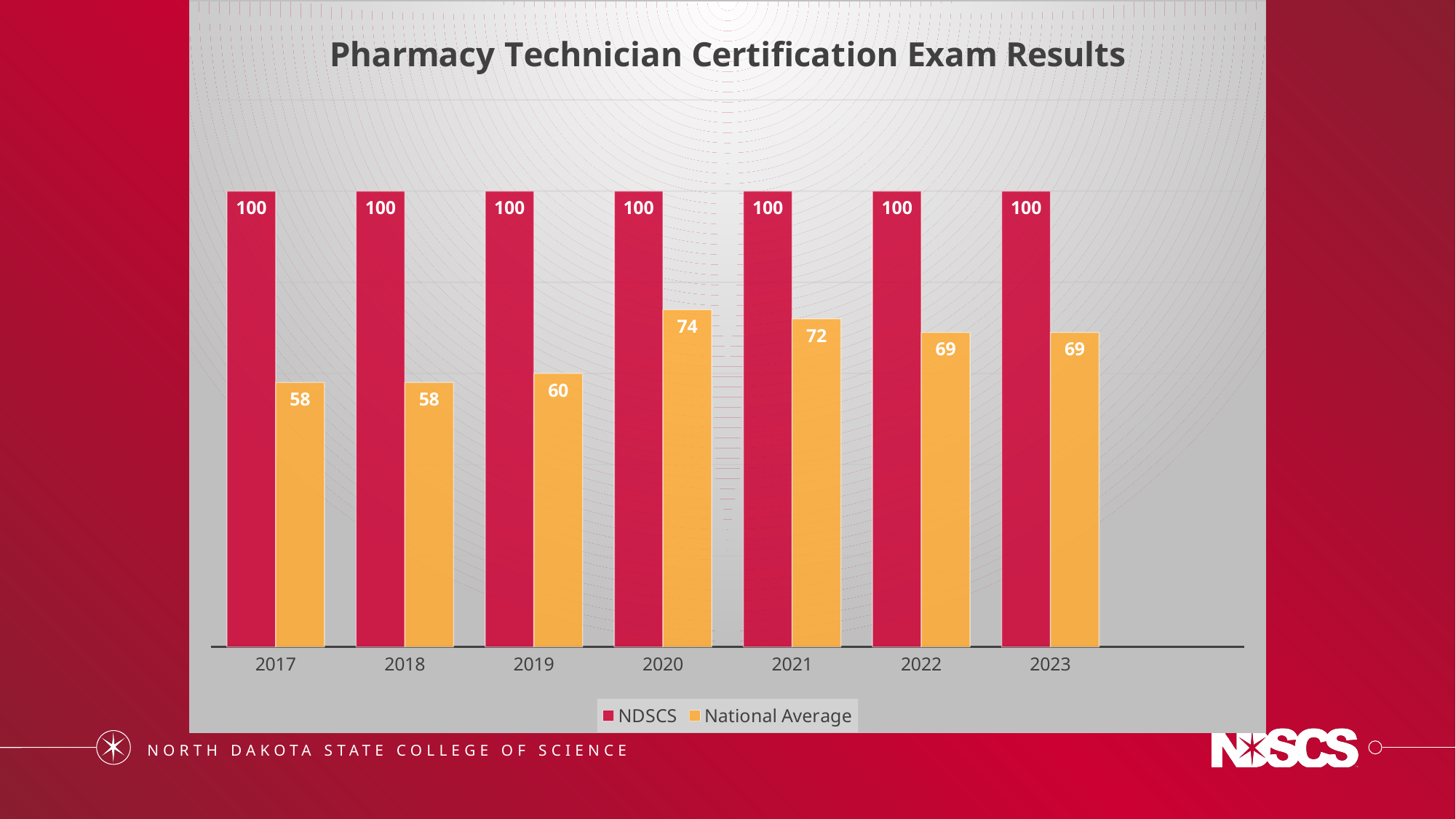
What is the National Average value for 2017? 58 What is the lowest National Average value shown? 58 How many series does the legend list? 2 What is the difference between the NDSCS and National Average values in 2021? 28 What kind of chart is shown? bar chart What is the title of the chart? Pharmacy Technician Certification Exam Results What is the NDSCS value for 2019? 100 What is the National Average value for 2020? 74 How many years are shown on the x axis? 7 Which is larger, the National Average for 2019 or for 2022? 2022 Which series is shown in orange? National Average In which year is the National Average highest? 2020